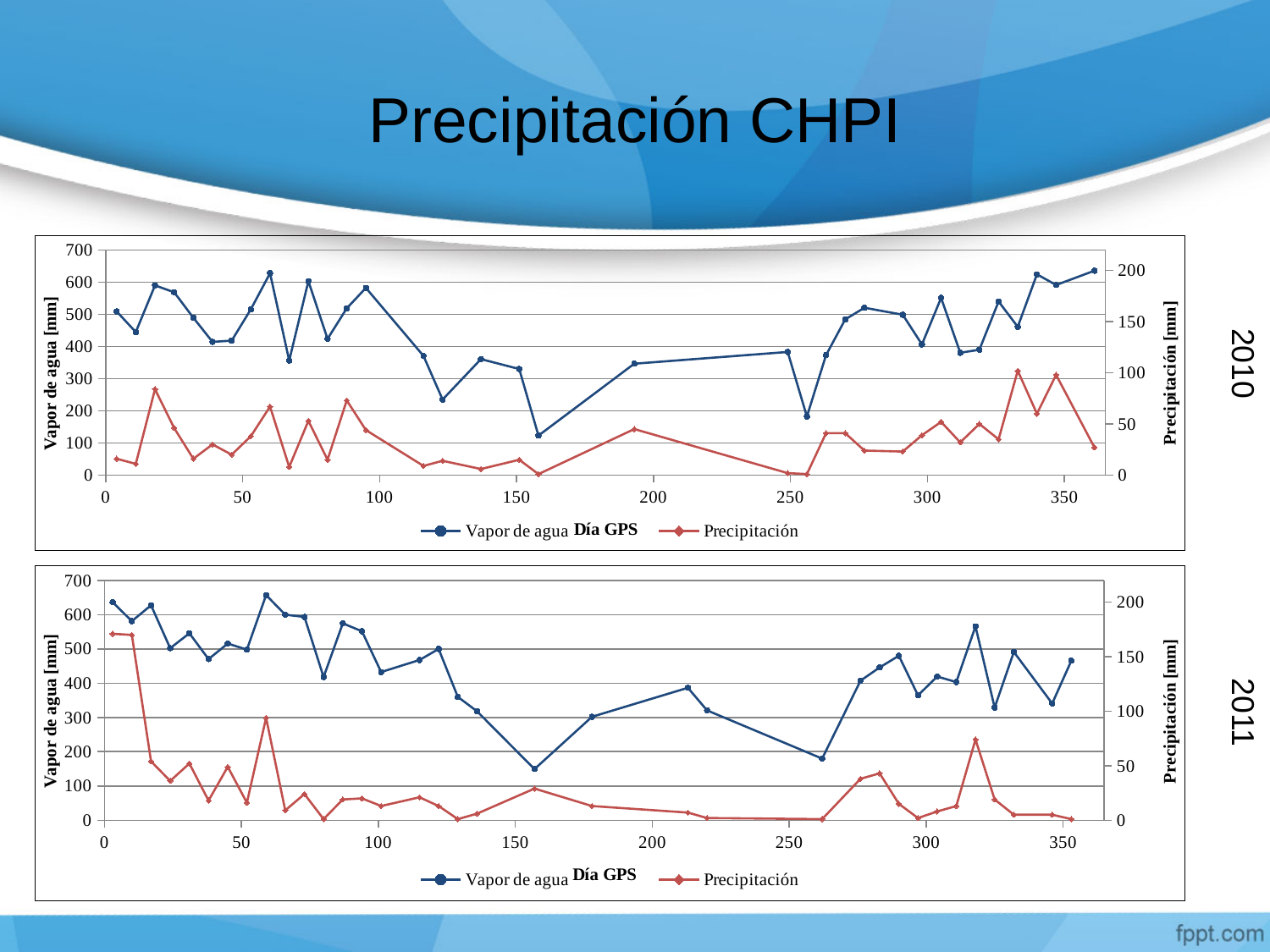
In the bottom (2011) chart, is the Precipitación value at about day 3 greater or less than 150? greater In the top (2010) chart, is the Vapor de agua value at about day 158 greater or less than 200? less In the top (2010) chart, does the Vapor de agua series rise or fall between about day 256 and day 270? rise In the bottom (2011) chart, is the Vapor de agua value at about day 60 greater or less than 600? greater In the top (2010) chart, what is the title of the left vertical axis? Vapor de agua [mm] What kind of chart is the top (2010) chart? line chart How many series does the legend of the bottom (2011) chart list? 2 In the bottom (2011) chart, what is the title of the right vertical axis? Precipitación [mm] In the bottom (2011) chart, does the Precipitación series rise or fall between about day 3 and day 18? fall